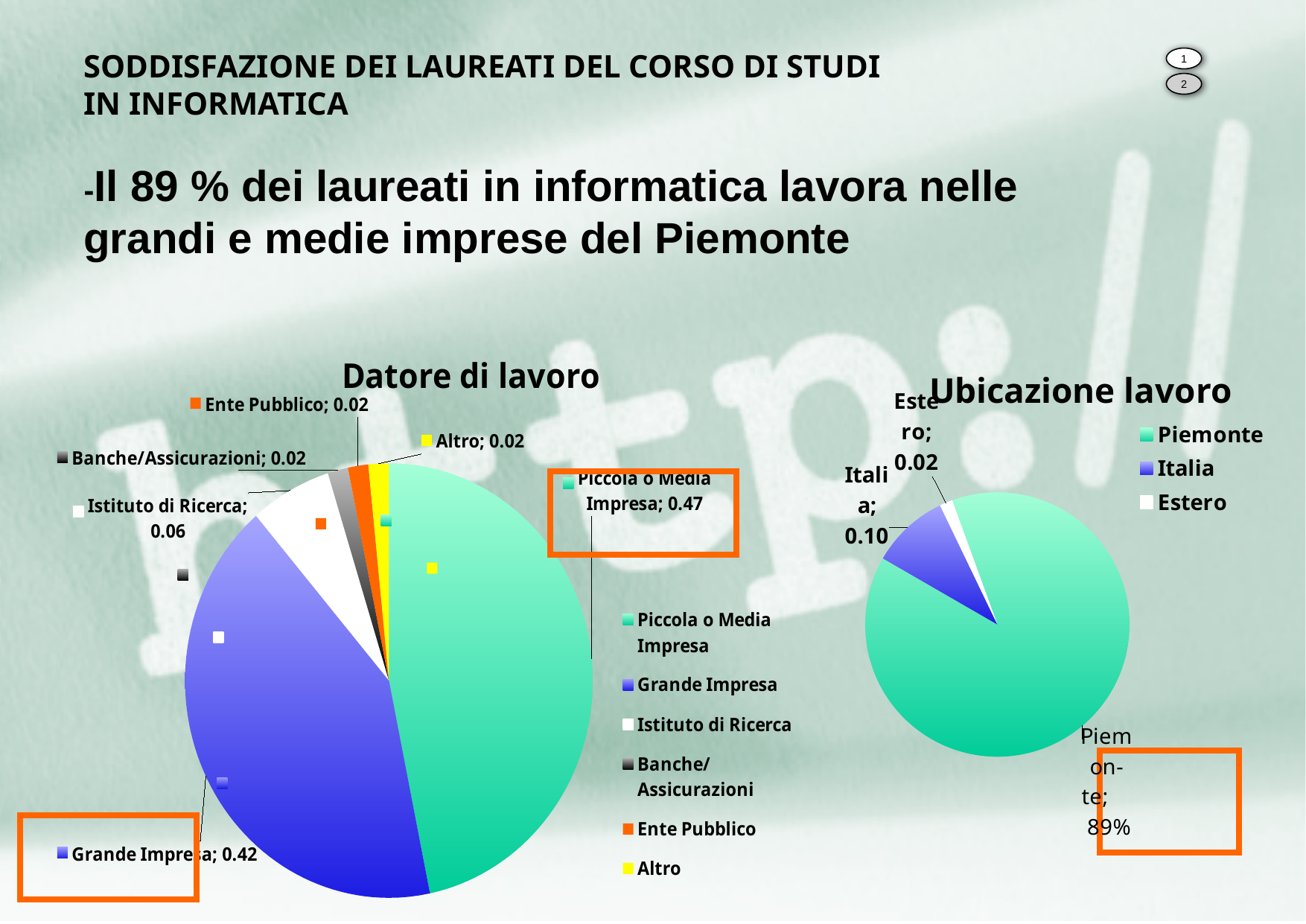
In the 'Datore di lavoro' chart, what is the value for Piccola o Media Impresa? 0.47 In the 'Datore di lavoro' chart, which category has the largest share? Piccola o Media Impresa In the 'Ubicazione lavoro' chart, what is the value for Piemonte? 89% In the 'Ubicazione lavoro' chart, which category has the smallest share? Estero What kind of chart is 'Datore di lavoro'? Pie chart In the 'Datore di lavoro' chart, what is the value for Istituto di Ricerca? 0.06 In the 'Datore di lavoro' chart, which is larger: Istituto di Ricerca or Ente Pubblico? Istituto di Ricerca In the 'Ubicazione lavoro' chart, what is the value for Italia? 0.10 In the 'Datore di lavoro' chart, what is the value for Grande Impresa? 0.42 How many categories does the legend of the 'Datore di lavoro' chart list? 6 How many categories does the legend of the 'Ubicazione lavoro' chart list? 3 In the 'Datore di lavoro' chart, what is the difference between the values for Piccola o Media Impresa and Grande Impresa? 0.05